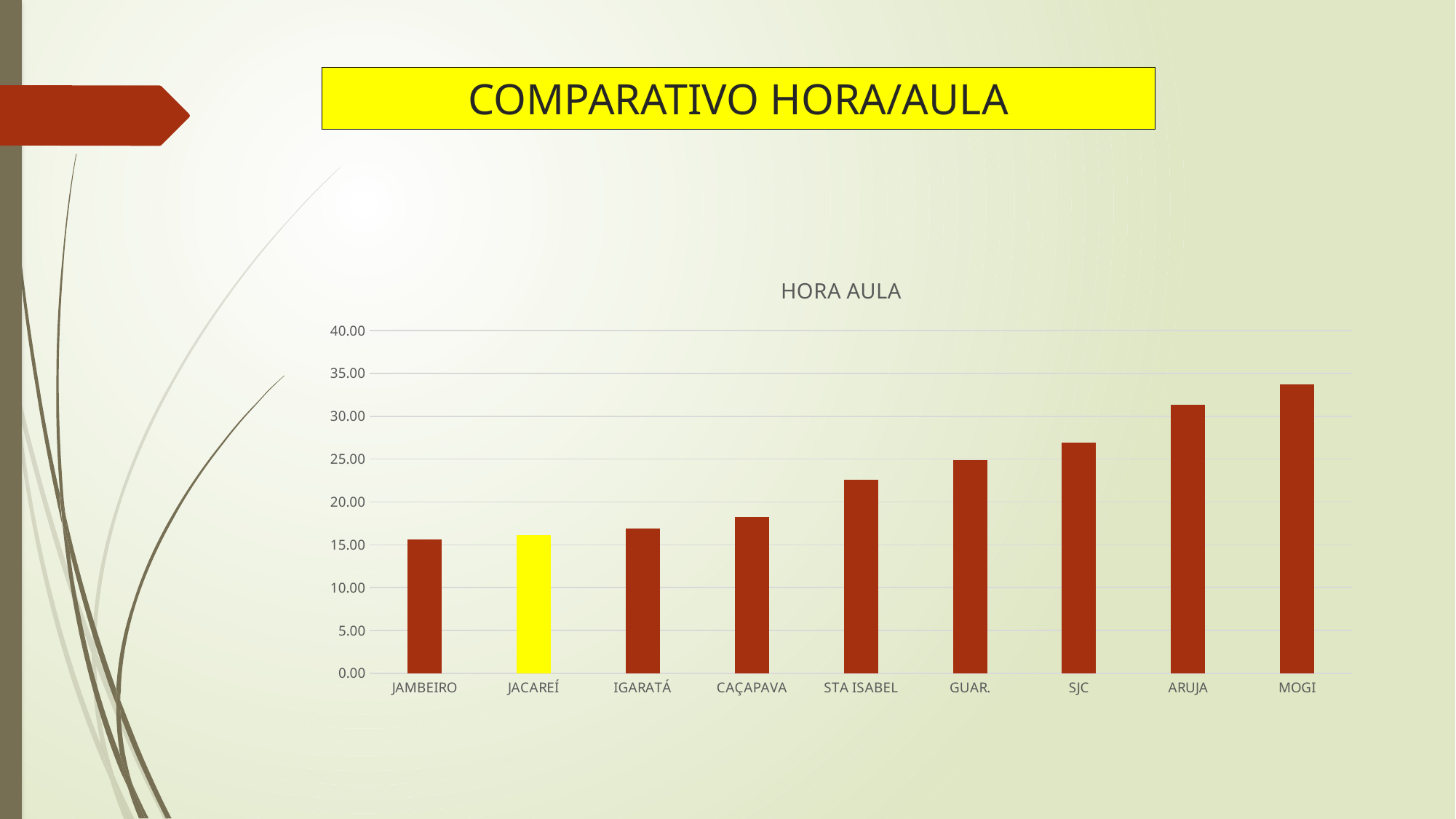
What is the title of the chart? HORA AULA Is the value for CAÇAPAVA greater or less than 20.00? less What kind of chart is shown on the slide? bar chart Is the value for JAMBEIRO greater or less than 20.00? less Which has a higher HORA AULA value, ARUJA or IGARATÁ? ARUJA Is the value for MOGI greater or less than 30.00? greater Do the values rise or fall from left to right across the cities? rise How many cities (categories) are shown in the chart? 9 Which city has the highest HORA AULA value? MOGI Which bar is highlighted in yellow? JACAREÍ